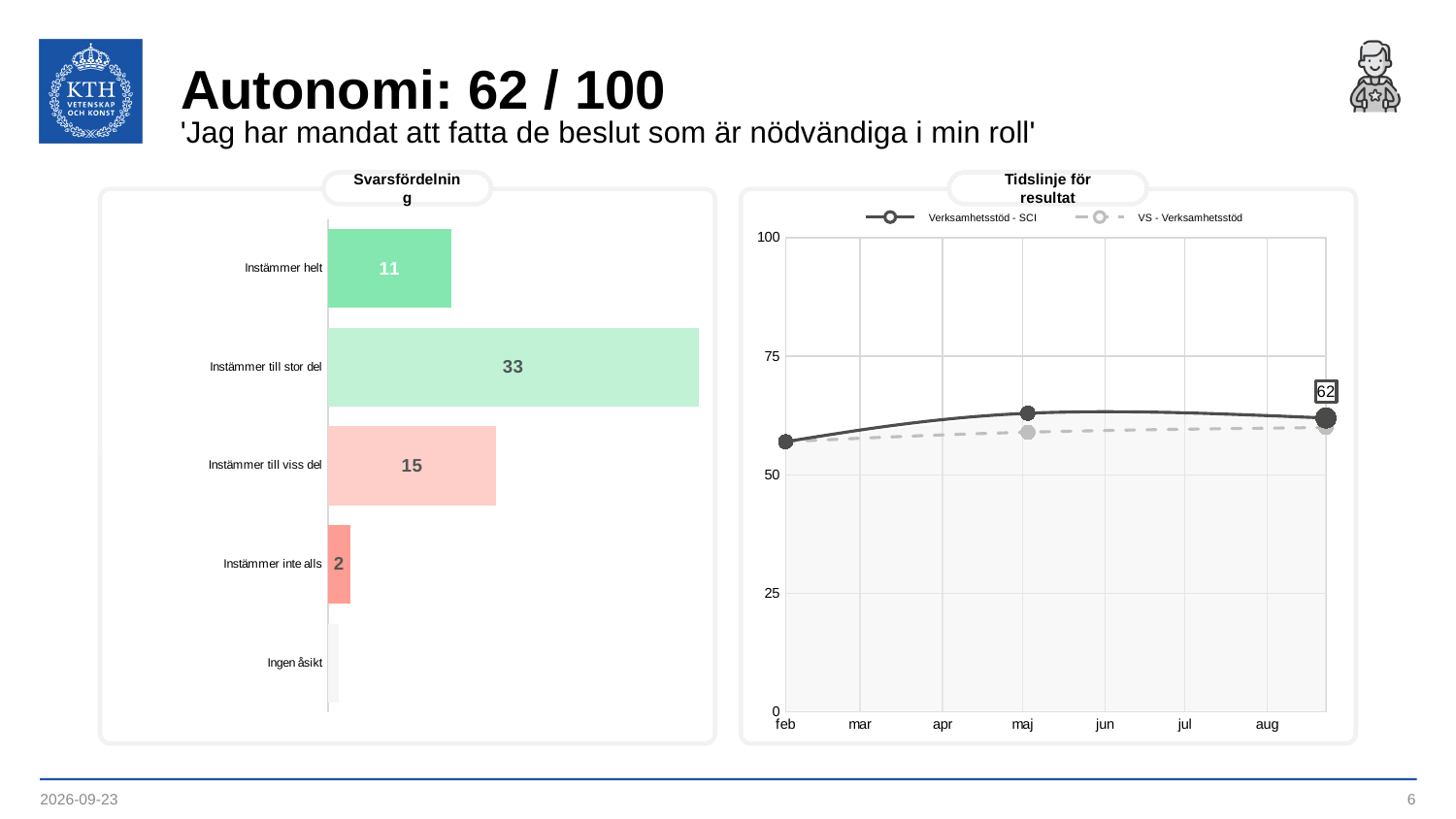
In the 'Svarsfördelning' chart, what is the value for 'Instämmer inte alls'? 2 In the 'Svarsfördelning' chart, which category has the highest value? Instämmer till stor del In the 'Svarsfördelning' chart, which is larger: 'Instämmer till viss del' or 'Instämmer helt'? Instämmer till viss del What kind of chart is the 'Tidslinje för resultat' chart? Line chart In the 'Svarsfördelning' chart, what is the value for 'Instämmer till stor del'? 33 What kind of chart is the 'Svarsfördelning' chart? Bar chart In the 'Svarsfördelning' chart, how many categories are shown? 5 In the 'Svarsfördelning' chart, what is the difference between 'Instämmer till stor del' and 'Instämmer till viss del'? 18 In the 'Svarsfördelning' chart, what is the value for 'Instämmer helt'? 11 In the 'Tidslinje för resultat' chart, is the value for 'Verksamhetsstöd - SCI' in feb greater or less than 50? greater In the 'Tidslinje för resultat' chart, what is the labelled value of the last point of the 'Verksamhetsstöd - SCI' series? 62 In the 'Tidslinje för resultat' chart, how many series does the legend list? 2